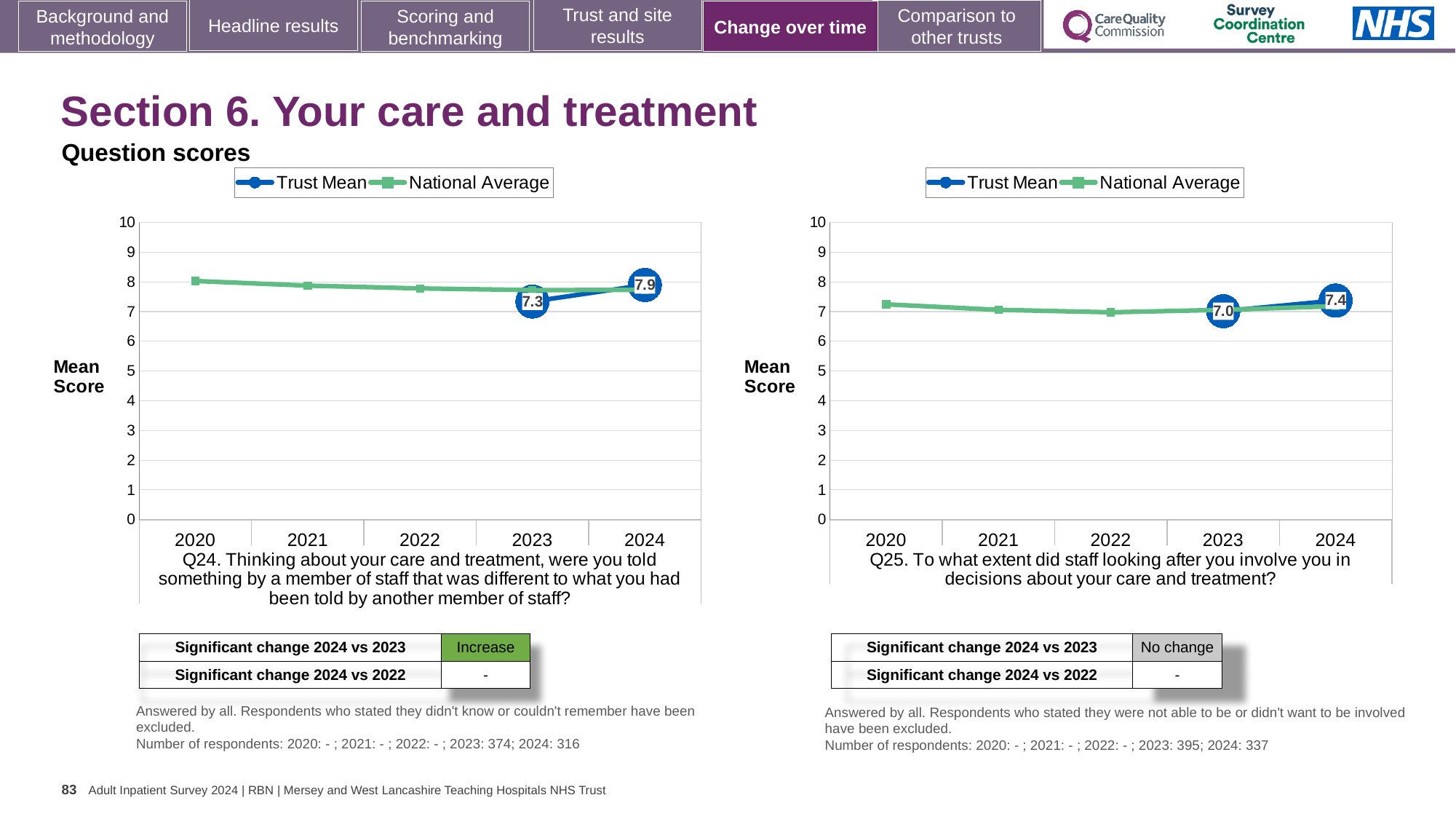
What type of chart is used for Q25 on the right? line chart In the Q25 chart on the right, is the Trust Mean for 2024 greater or less than 7? greater In the Q25 chart on the right, what is the Trust Mean score for 2024? 7.4 In the Q24 chart on the left, what is the Trust Mean score for 2024? 7.9 In the Q24 chart on the left, is the National Average for 2020 greater or less than 7? greater In the Q24 chart on the left, by how much did the Trust Mean change from 2023 to 2024? 0.6 How many years are shown on the x axis of the Q24 chart on the left? 5 In the Q25 chart on the right, what is the difference between the Trust Mean in 2024 and in 2023? 0.4 How many series does the legend of the Q25 chart on the right list? 2 In the Q25 chart on the right, what is the Trust Mean score for 2023? 7.0 In the Q24 chart on the left, did the Trust Mean rise or fall from 2023 to 2024? rise In the Q24 chart on the left, what is the Trust Mean score for 2023? 7.3